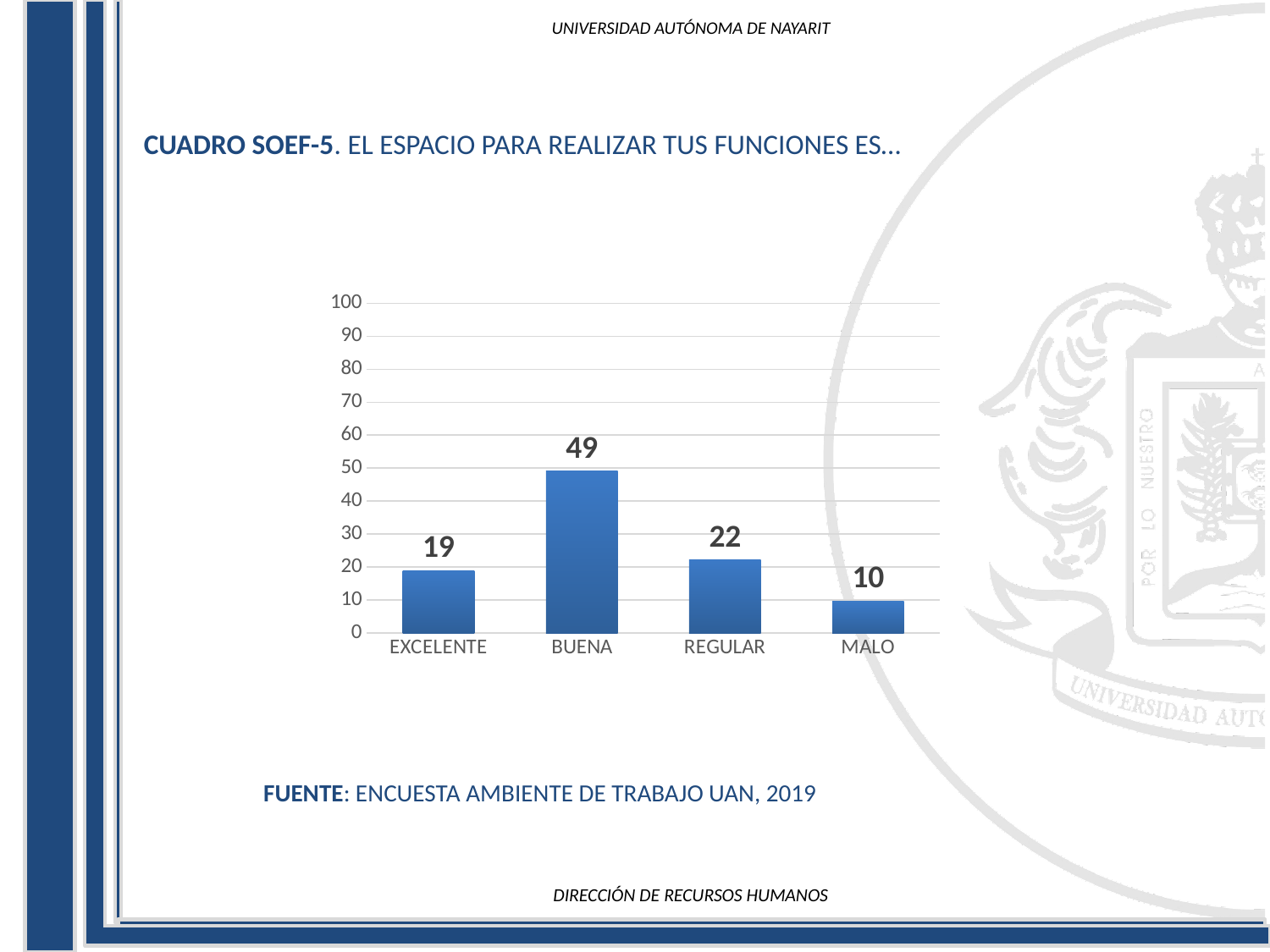
What is the value for MALO? 10 What is the total of the values for all four categories? 100 What kind of chart is shown on the slide? bar chart What is the value for BUENA? 49 What is the difference between the values for BUENA and REGULAR? 27 Which category has the highest value? BUENA Which is larger, the value for REGULAR or the value for EXCELENTE? REGULAR How many categories are shown on the x axis? 4 What is the maximum value shown on the vertical axis? 100 Is the value for BUENA greater or less than 40? greater Which category has the lowest value? MALO What is the value for EXCELENTE? 19